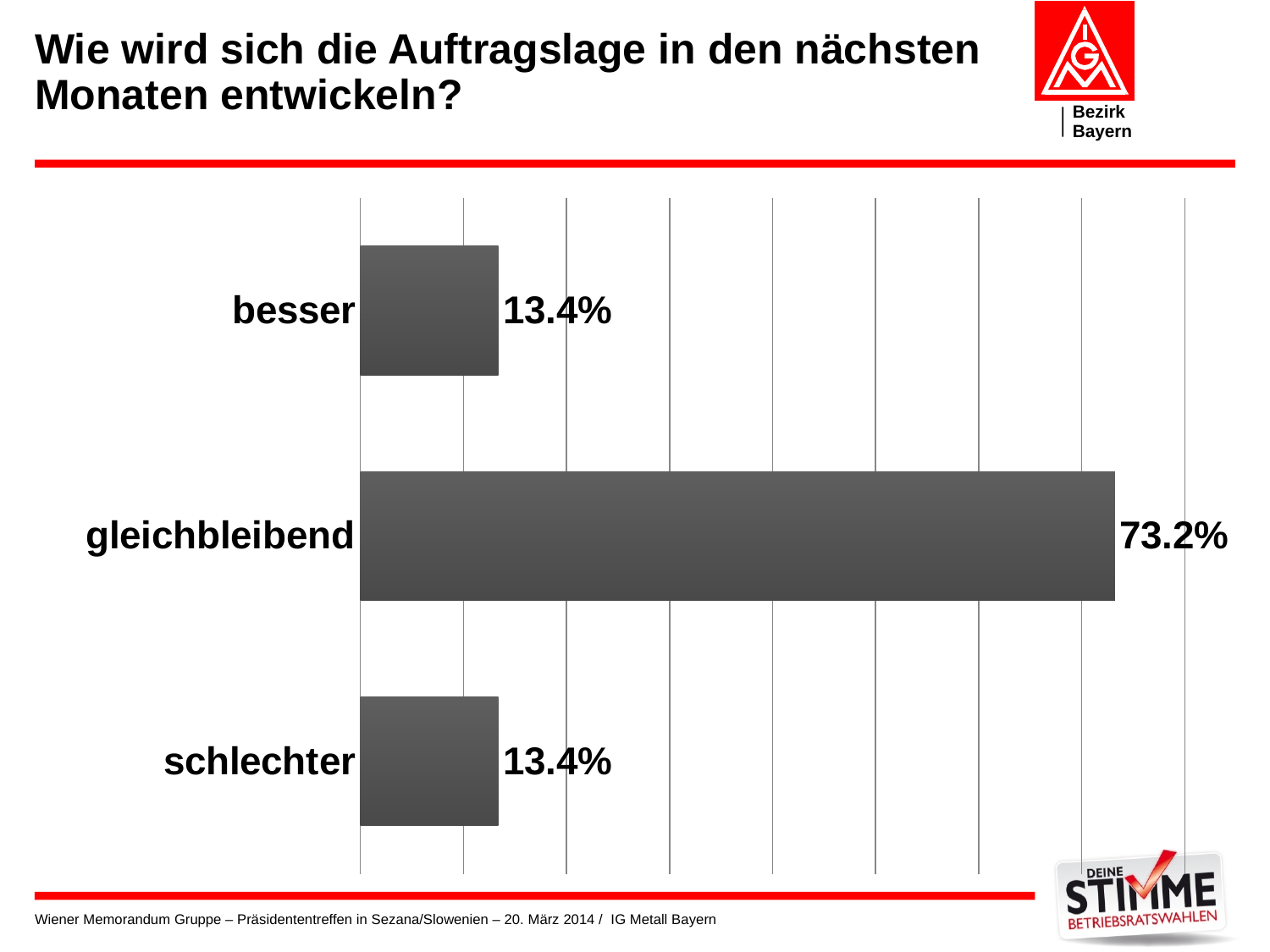
What is the total of the three values shown in the chart? 100% What is the difference between the values for "gleichbleibend" and "besser"? 59.8% Do "besser" and "schlechter" have the same value? Yes Which category has the highest value? gleichbleibend What is the value for "gleichbleibend"? 73.2% What kind of chart is shown on the slide? Bar chart What is the value for "besser"? 13.4% How many categories are shown in the chart? 3 What is the title of the slide containing the chart? Wie wird sich die Auftragslage in den nächsten Monaten entwickeln? What is the value for "schlechter"? 13.4% What is the difference between the values for "gleichbleibend" and "schlechter"? 59.8% Which is larger, the value for "gleichbleibend" or the value for "schlechter"? gleichbleibend